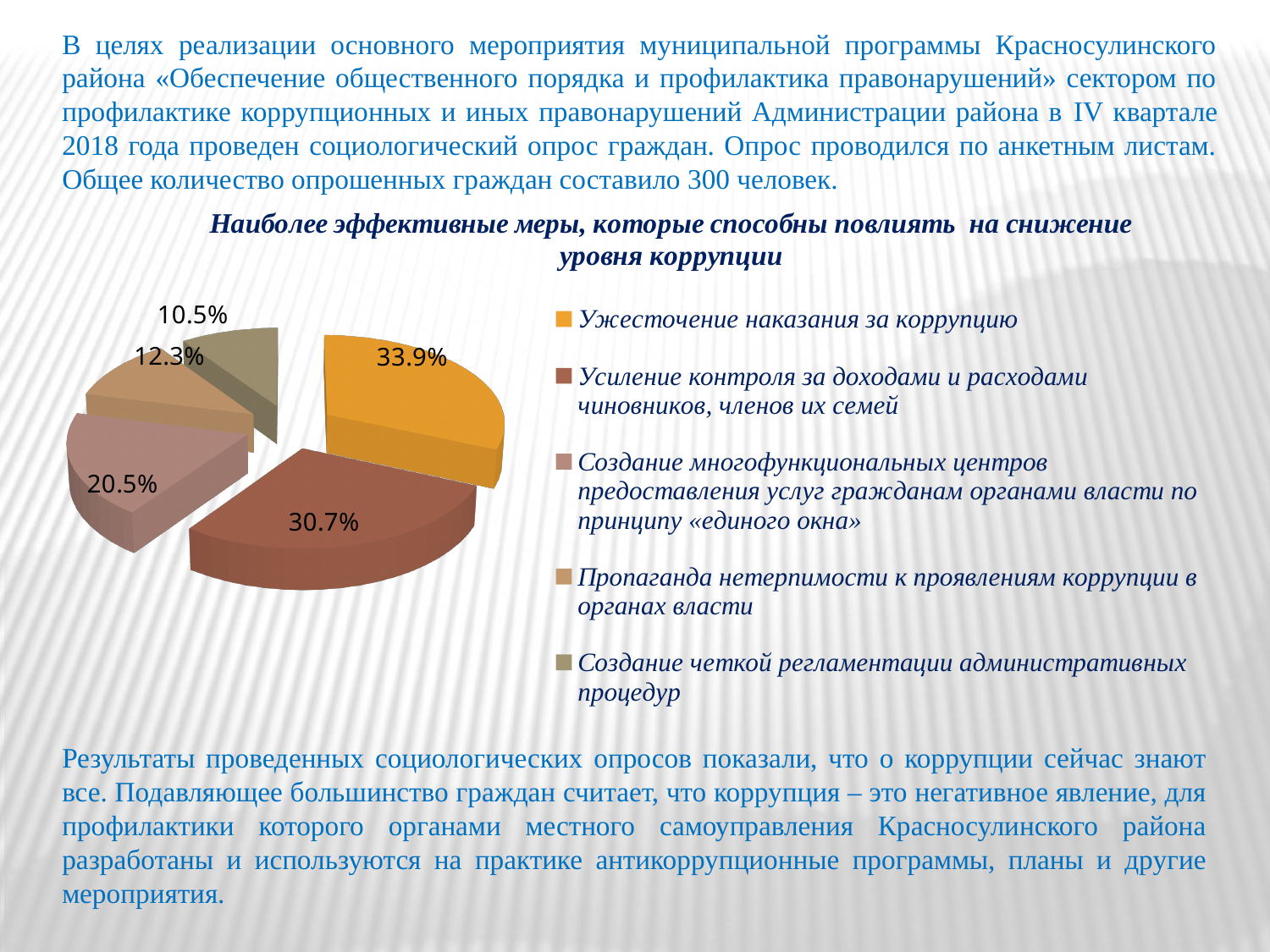
What share of the pie does "Ужесточение наказания за коррупцию" have? 33.9% What is the title of the pie chart? Наиболее эффективные меры, которые способны повлиять на снижение уровня коррупции How many slices does the pie chart have? 5 What share of the pie does "Создание четкой регламентации административных процедур" have? 10.5% Which measure has the largest slice of the pie? Ужесточение наказания за коррупцию What share of the pie does "Пропаганда нетерпимости к проявлениям коррупции в органах власти" have? 12.3% Which measure has the smallest slice of the pie? Создание четкой регламентации административных процедур What kind of chart is shown on the slide? Pie chart What share of the pie does "Усиление контроля за доходами и расходами чиновников, членов их семей" have? 30.7% Which is larger: the share for "Пропаганда нетерпимости к проявлениям коррупции в органах власти" or for "Создание четкой регламентации административных процедур"? Пропаганда нетерпимости к проявлениям коррупции в органах власти What share of the pie does "Создание многофункциональных центров предоставления услуг гражданам органами власти по принципу «единого окна»" have? 20.5% What is the difference between the shares for "Ужесточение наказания за коррупцию" and "Усиление контроля за доходами и расходами чиновников, членов их семей"? 3.2%